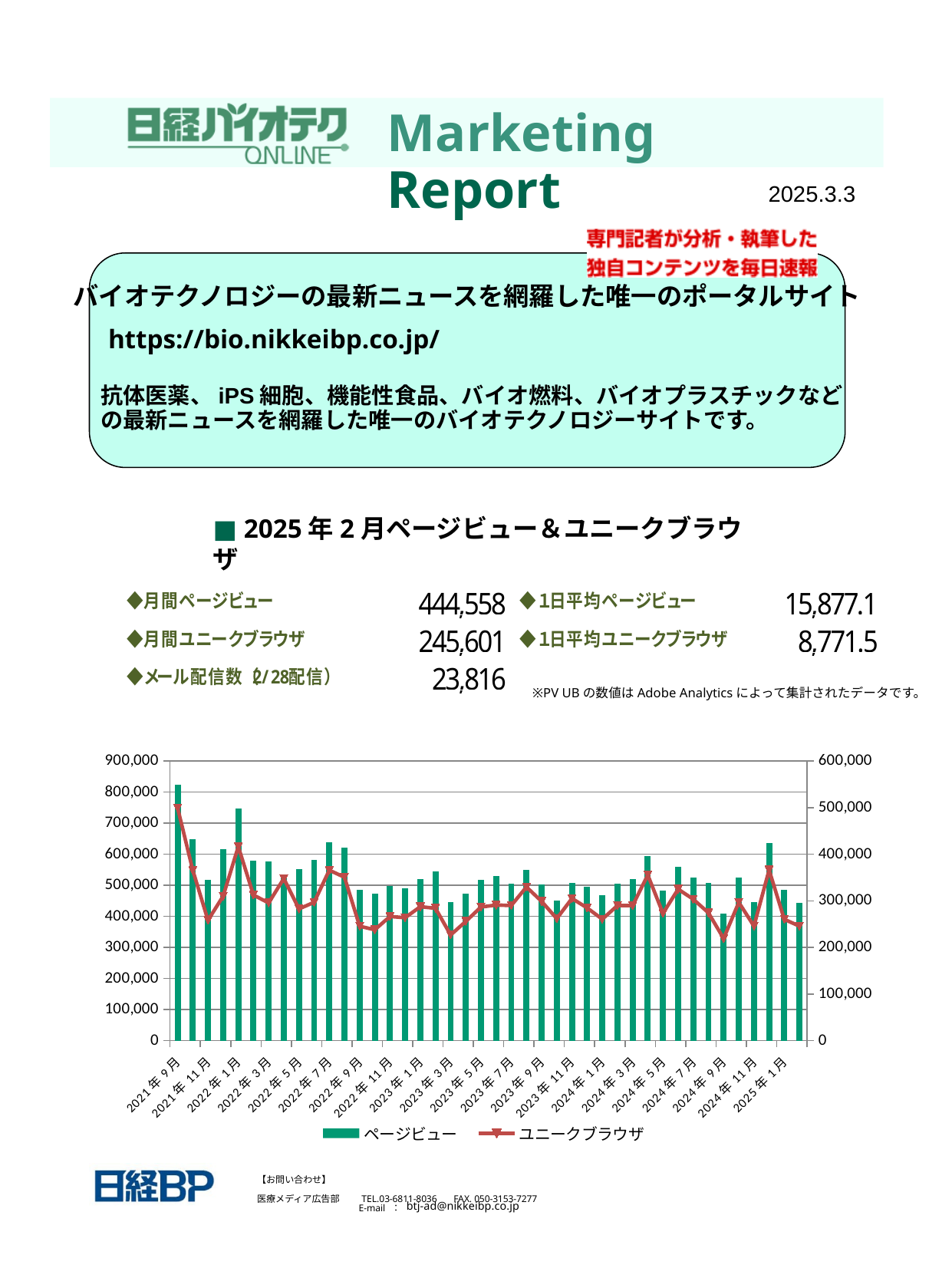
In which month is the ページビュー bar highest? 2021年9月 Is the ユニークブラウザ value for 2023年3月 greater or less than 300,000 on the right axis? less What kind of chart is shown on the slide? A combined bar and line chart Do the ページビュー values rise or fall from 2021年9月 to 2021年11月? fall How many series does the chart legend list? 2 Is the ユニークブラウザ value for 2021年9月 greater or less than 400,000 on the right axis? greater Is the ページビュー value for 2021年9月 greater or less than 700,000? greater Which series is drawn as a line in the chart? ユニークブラウザ In which month does the ユニークブラウザ line reach its highest point? 2021年9月 Which month has the larger ページビュー value, 2021年9月 or 2023年1月? 2021年9月 Which series is drawn as bars in the chart? ページビュー